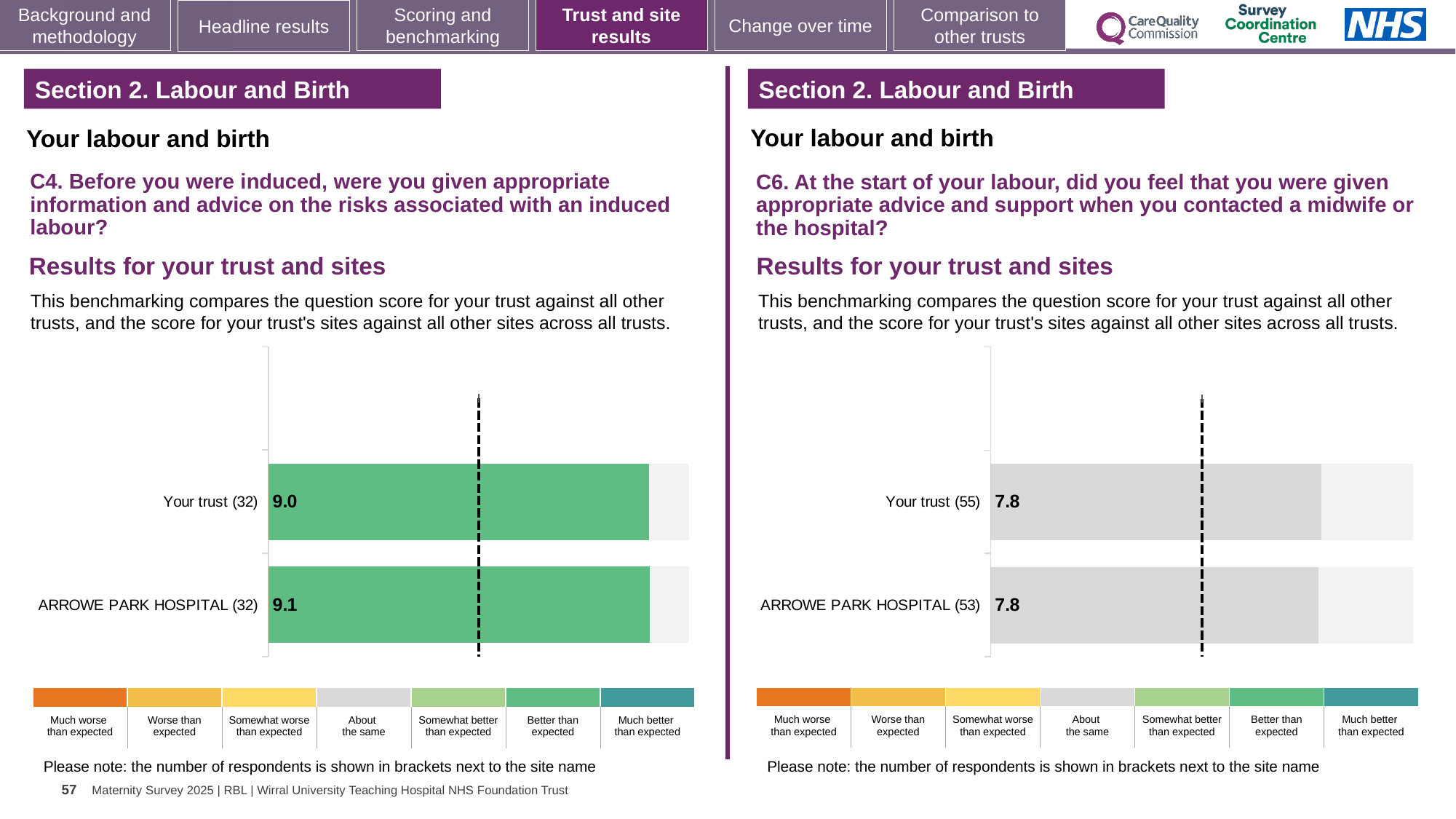
In the C4 chart on the left, which has the higher score, Your trust or ARROWE PARK HOSPITAL? ARROWE PARK HOSPITAL In the C6 chart on the right, what is the difference between the Your trust score and the ARROWE PARK HOSPITAL score? 0.0 In the C4 chart on the left, what is the score for ARROWE PARK HOSPITAL? 9.1 In the C6 chart on the right, how many respondents are shown in brackets for Your trust? 55 In the C6 chart on the right, what is the score for ARROWE PARK HOSPITAL? 7.8 In the C4 chart on the left, which benchmark category does the green colour of the bars correspond to in the legend? Better than expected In the C6 chart on the right, what is the score for Your trust? 7.8 In the C6 chart on the right, which benchmark category does the grey colour of the bars correspond to in the legend? About the same How many bars are shown in the C4 chart on the left? 2 In the C4 chart on the left, what is the score for Your trust? 9.0 In the C4 chart on the left, what is the difference between the ARROWE PARK HOSPITAL score and the Your trust score? 0.1 What type of chart is used in the C6 chart on the right? Bar chart